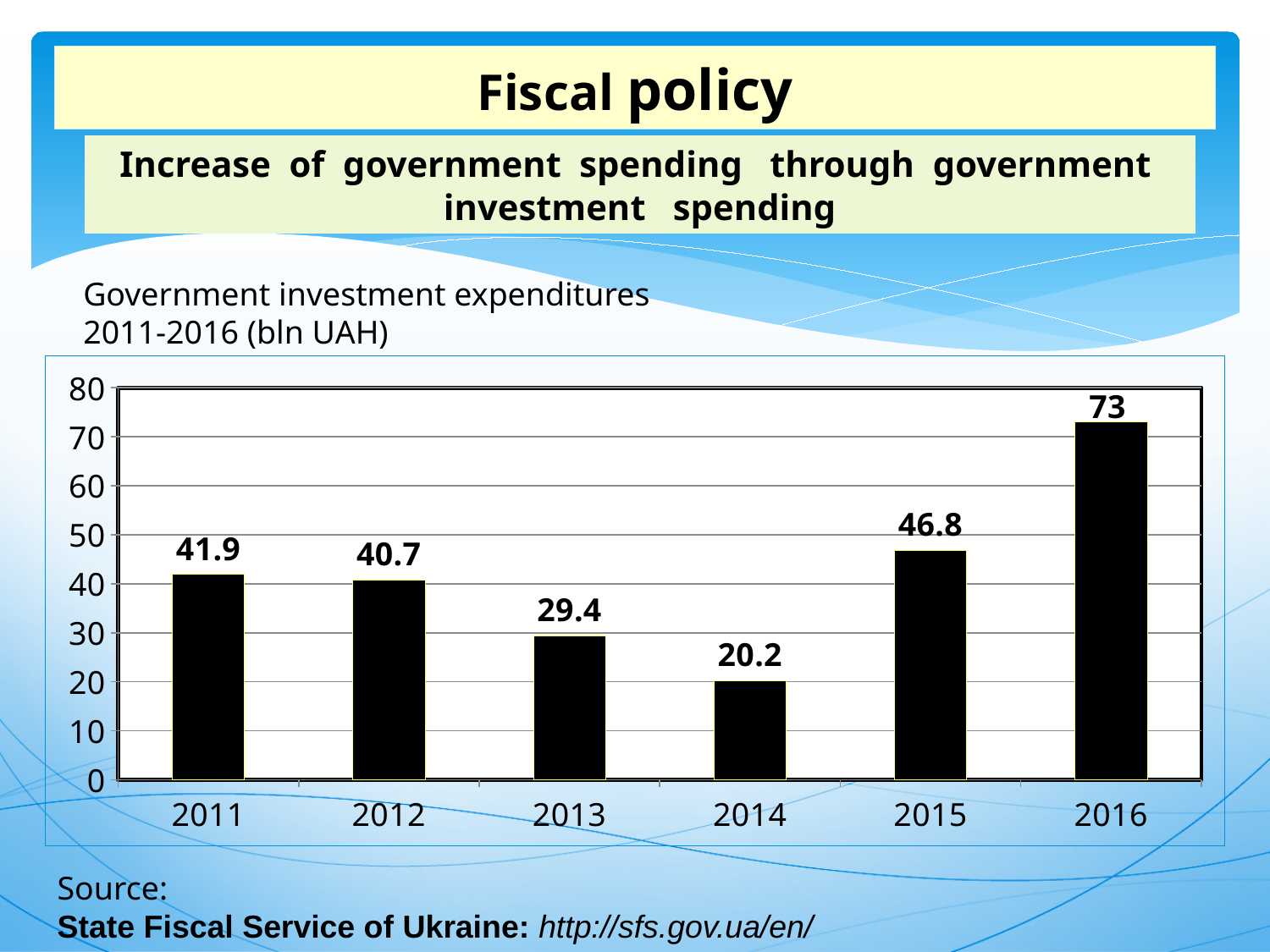
What is the value for 2011? 41.9 What kind of chart is shown? bar chart How many years are shown on the chart? 6 What unit is given in the chart title for the expenditures? bln UAH Which year has the lowest government investment expenditure? 2014 What is the value for 2016? 73 What is the difference between the values for 2016 and 2015? 26.2 Which year has the highest government investment expenditure? 2016 Which is larger, the value for 2013 or the value for 2015? 2015 What is the difference between the values for 2011 and 2012? 1.2 What is the value for 2014? 20.2 Is the value for 2016 greater or less than 70? greater